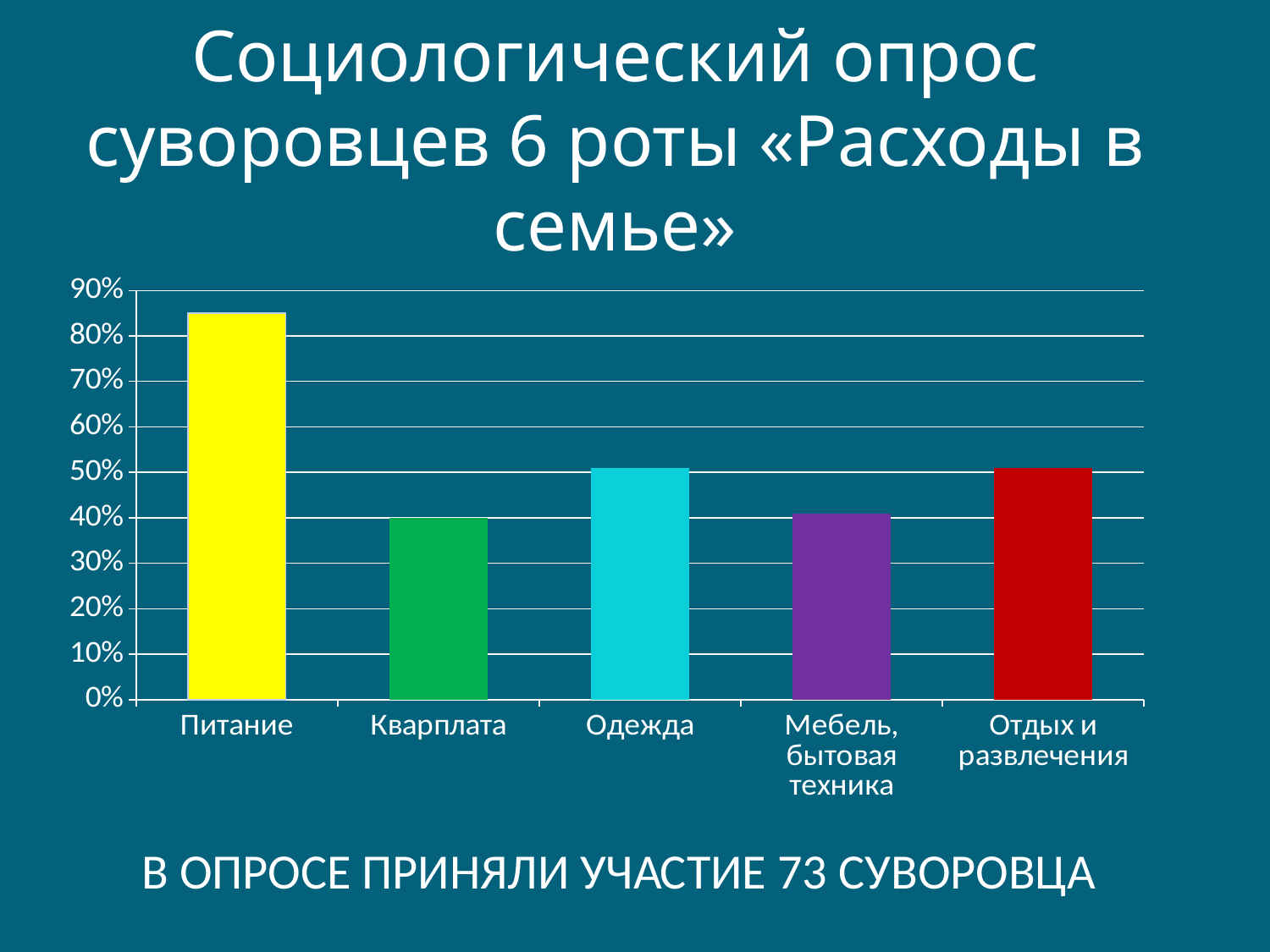
What is the title of the slide containing the chart? Социологический опрос суворовцев 6 роты «Расходы в семье» Which category has the highest value in the chart? Питание Is the value for Квартплата greater or less than 50%? less How many categories are shown on the x axis of the chart? 5 What colour is the bar for Питание? Yellow Is the value for Отдых и развлечения greater or less than 60%? less Which is larger, the value for Питание or the value for Квартплата? Питание What kind of chart is shown on the slide? Bar chart Is the value for Одежда greater or less than 40%? greater Which is larger, the value for Одежда or the value for Мебель, бытовая техника? Одежда